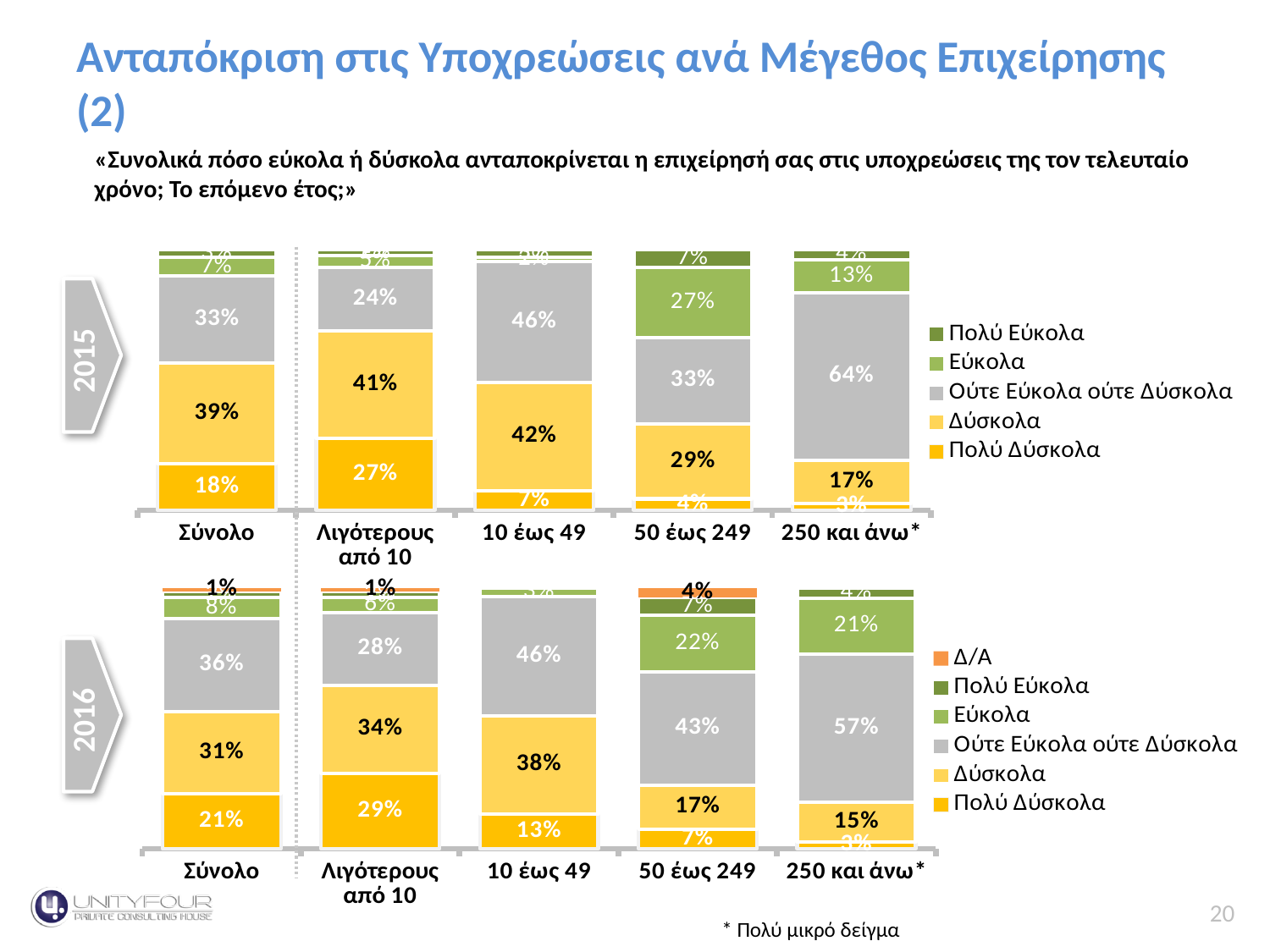
In the 2016 chart (bottom), what is the value of Πολύ Δύσκολα for Σύνολο? 21% In the 2015 chart (top), what is the value of Δύσκολα for Σύνολο? 39% In the 2015 chart (top), what is the value of Εύκολα for 50 έως 249? 27% In the 2015 chart (top), what is the difference between the Δύσκολα values for Λιγότερους από 10 and Σύνολο? 2% In the 2015 chart (top), what is the value of Πολύ Δύσκολα for Λιγότερους από 10? 27% In the 2015 chart (top), what is the value of Ούτε Εύκολα ούτε Δύσκολα for 250 και άνω*? 64% In the 2016 chart (bottom), what is the value of Δ/Α for 50 έως 249? 4% What kind of chart is the 2015 chart (top)? Stacked bar chart How many series does the legend of the 2016 chart (bottom) list? 6 In the 2016 chart (bottom), which category has the highest Ούτε Εύκολα ούτε Δύσκολα value? 250 και άνω* In the 2016 chart (bottom), what is the value of Ούτε Εύκολα ούτε Δύσκολα for 10 έως 49? 46% In the 2016 chart (bottom), which is larger: Δύσκολα for Λιγότερους από 10 or Δύσκολα for 50 έως 249? Λιγότερους από 10